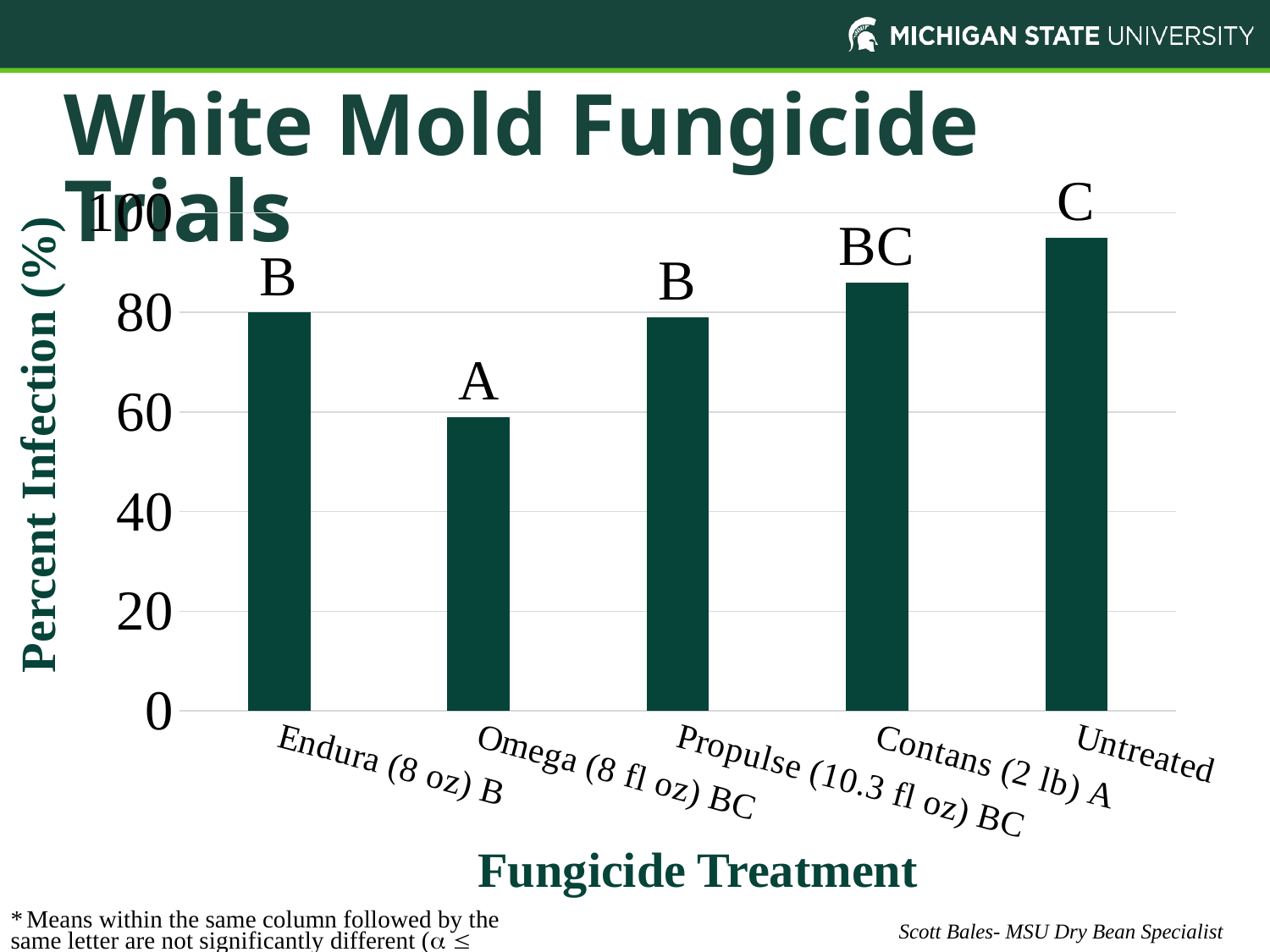
Which treatment has the highest percent infection? Untreated Is the percent infection for Untreated greater or less than 80? greater What is the title of the vertical axis? Percent Infection (%) Which treatment has the lowest percent infection? Omega (8 fl oz) BC Which has a higher percent infection, Untreated or Contans (2 lb) A? Untreated What kind of chart is shown on the slide? bar chart How many fungicide treatments are plotted on the chart? 5 Is the percent infection for Contans (2 lb) A greater or less than 80? greater Is the percent infection for Propulse (10.3 fl oz) BC greater or less than 60? greater Which has a lower percent infection, Omega (8 fl oz) BC or Propulse (10.3 fl oz) BC? Omega (8 fl oz) BC What letter is printed above the Omega (8 fl oz) BC bar? A